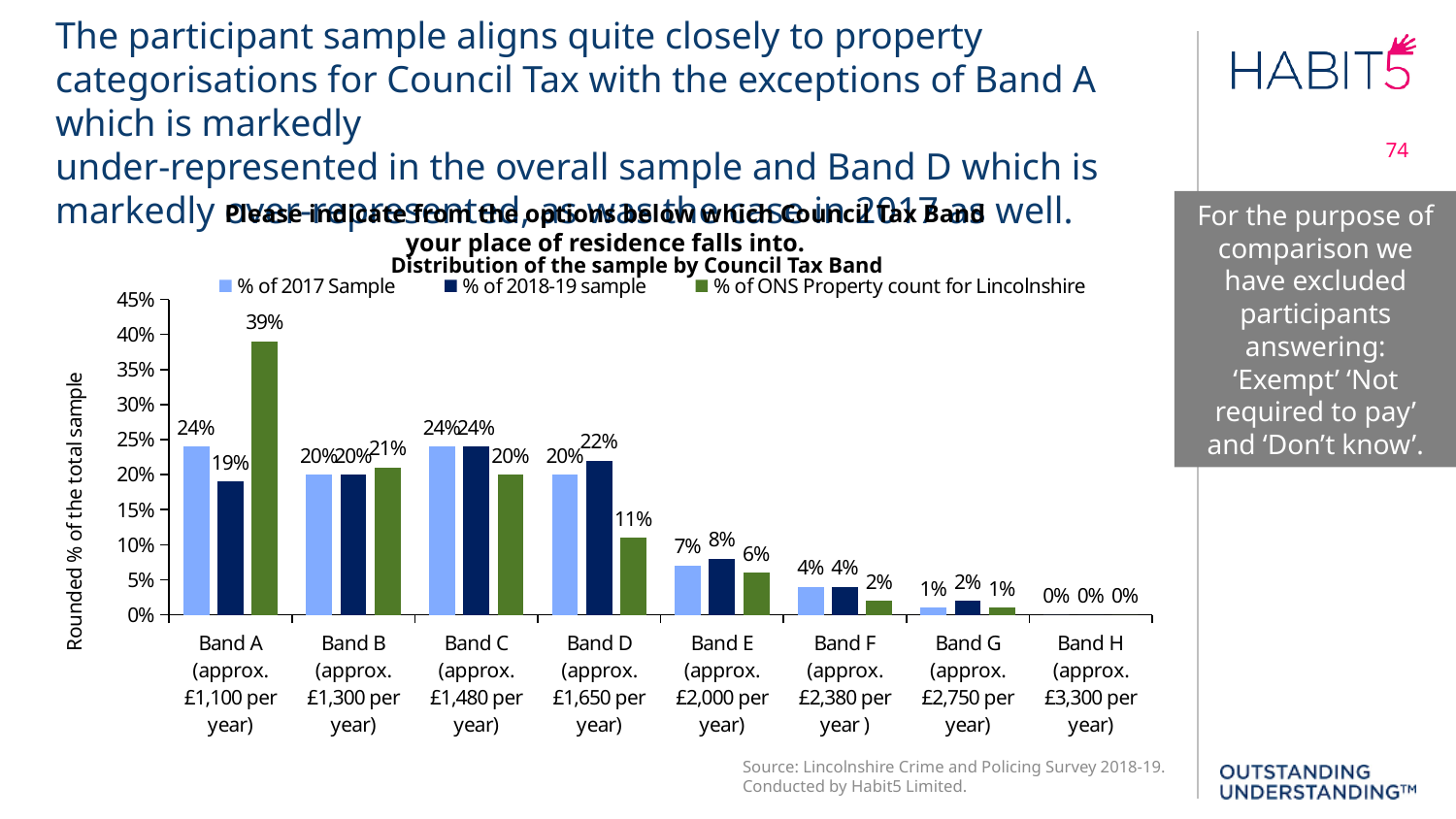
What kind of chart is used to show the distribution of the sample by Council Tax Band? Bar chart How many series does the legend list? 3 For Band A, which is larger: the % of 2017 Sample or the % of 2018-19 sample? % of 2017 Sample What is the difference between the % of 2017 Sample and the % of 2018-19 sample for Band A? 5% Which Council Tax Band has the lowest % of 2018-19 sample? Band H Which Council Tax Band has the highest % of ONS Property count for Lincolnshire? Band A What is the difference between the % of 2018-19 sample and the % of ONS Property count for Lincolnshire for Band D? 11% What is the % of ONS Property count for Lincolnshire for Band A? 39% How many Council Tax Bands are shown on the x axis? 8 What is the % of 2017 Sample for Band E? 7% What is the % of 2018-19 sample for Band D? 22% Is the % of ONS Property count for Lincolnshire for Band A greater or less than 35%? greater